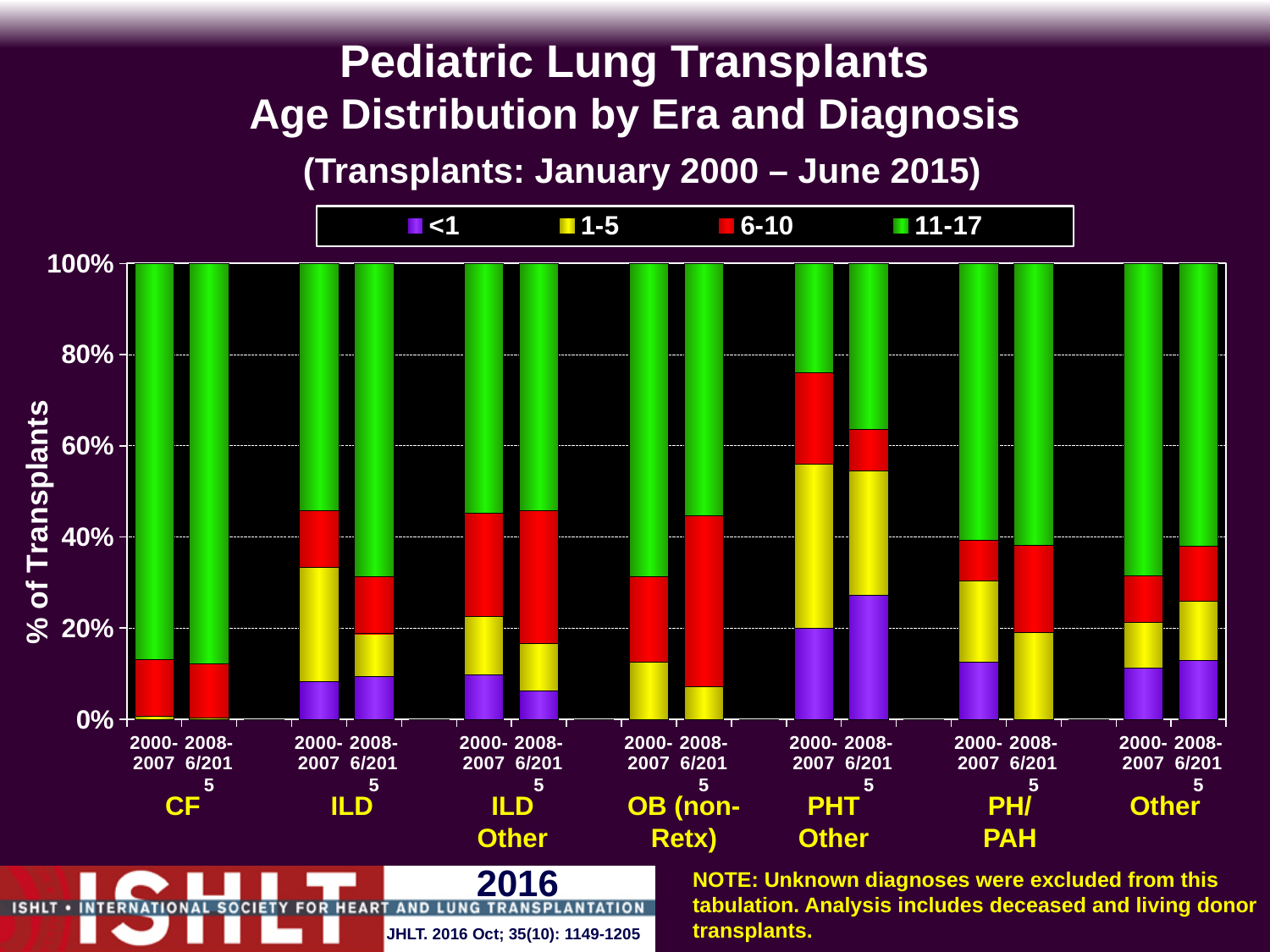
Is the share of 11-17 year olds for PHT Other in 2000-2007 greater or less than 40%? less What is the label of the y axis? % of Transplants Which age group is shown in green in the legend? 11-17 How many age-group series does the legend list? 4 What kind of chart is shown on the slide? Stacked bar chart Is the share of <1 year olds for PHT Other in 2008-6/2015 greater or less than 20%? greater In the 2000-2007 era, is the share of 11-17 year olds larger for CF or for ILD? CF Which diagnosis group has the largest share of <1 year olds in the 2008-6/2015 era? PHT Other How many bars are plotted in the chart in total? 14 Which diagnosis group has the smallest share of 11-17 year olds in the 2000-2007 era? PHT Other How many diagnosis groups are shown along the x axis? 7 Is the share of 11-17 year olds for CF in 2000-2007 greater or less than 80%? greater